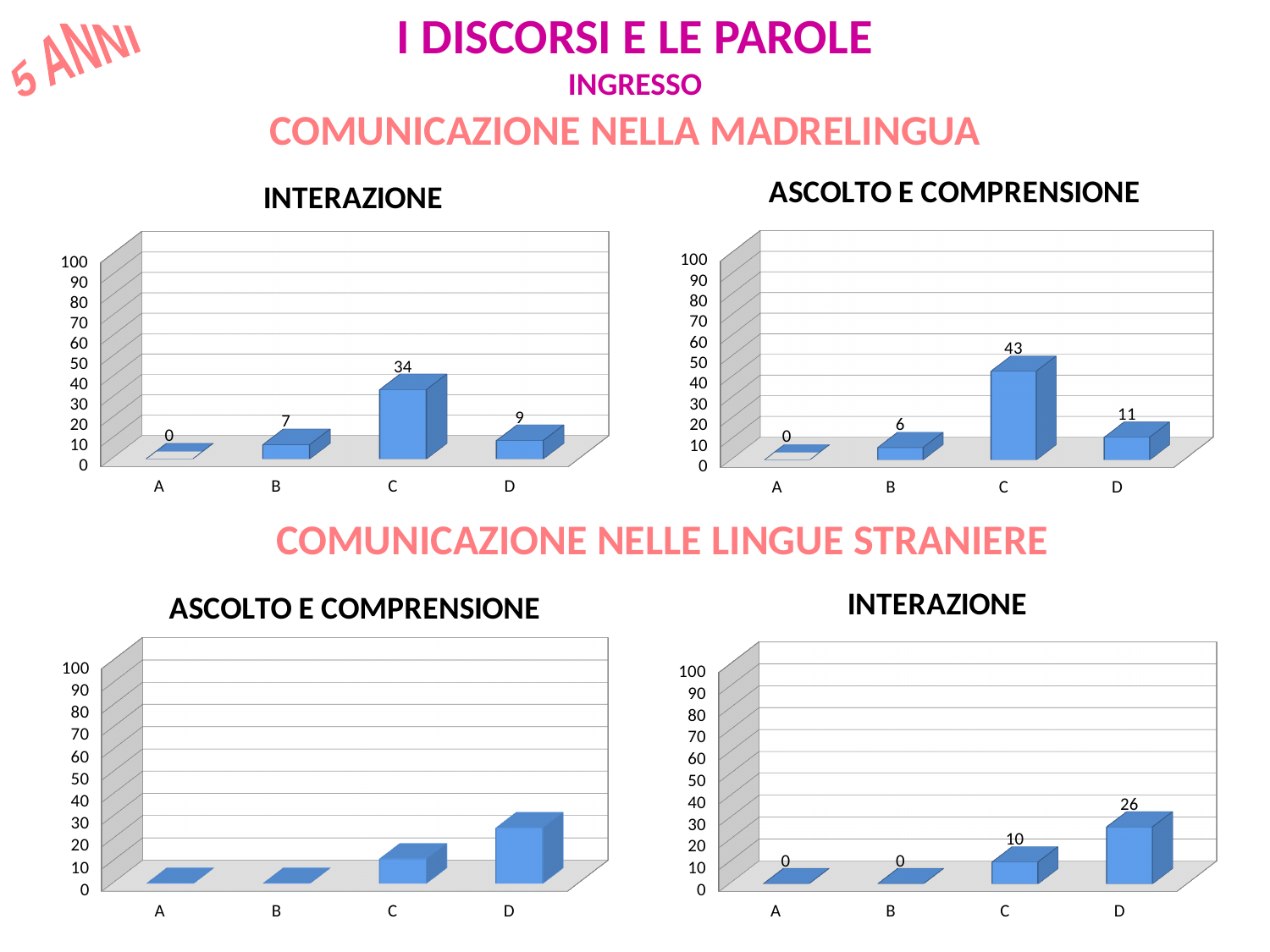
In the top-left INTERAZIONE chart, what is the difference between the values for C and D? 25 In the top-left INTERAZIONE chart, what is the value for B? 7 In the bottom-left ASCOLTO E COMPRENSIONE chart, is the value for D greater or less than 20? greater In the top-right ASCOLTO E COMPRENSIONE chart, what is the value for D? 11 In the bottom-left ASCOLTO E COMPRENSIONE chart, which category has the highest value? D In the top-right ASCOLTO E COMPRENSIONE chart, what is the value for C? 43 In the top-right ASCOLTO E COMPRENSIONE chart, which category has the highest value? C In the top-left INTERAZIONE chart, what is the value for C? 34 What kind of chart is the top-left INTERAZIONE chart? bar chart How many categories are shown on the x axis of the top-right ASCOLTO E COMPRENSIONE chart? 4 In the bottom-right INTERAZIONE chart, which is larger, the value for C or the value for D? D In the bottom-right INTERAZIONE chart, what is the value for D? 26